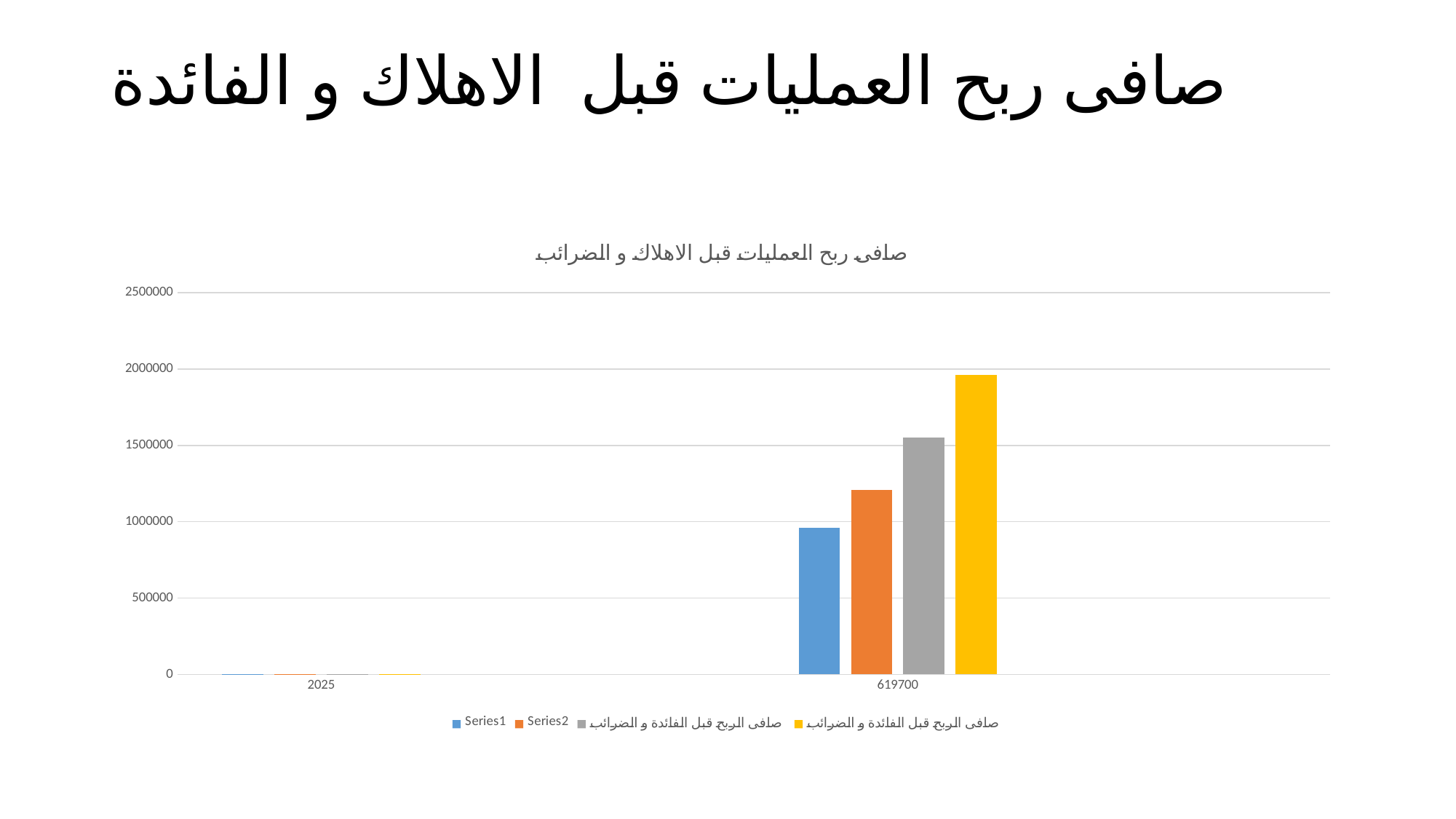
In the 619700 category, is the value of the gray bar greater or less than 2000000? less What kind of chart is shown on the slide? bar chart Which colour bar is the tallest in the 619700 category? yellow How many series does the chart legend list? 4 In the 619700 category, which is larger, Series1 or Series2? Series2 What are the two category labels on the x axis? 2025 and 619700 In the 619700 category, is the value for Series1 greater or less than 500000? greater Do the values rise or fall from the 2025 category to the 619700 category? rise Which series has the lowest value in the 619700 category? Series1 How many categories are shown on the x axis of the chart? 2 In the 619700 category, is the value of the yellow bar greater or less than 1500000? greater